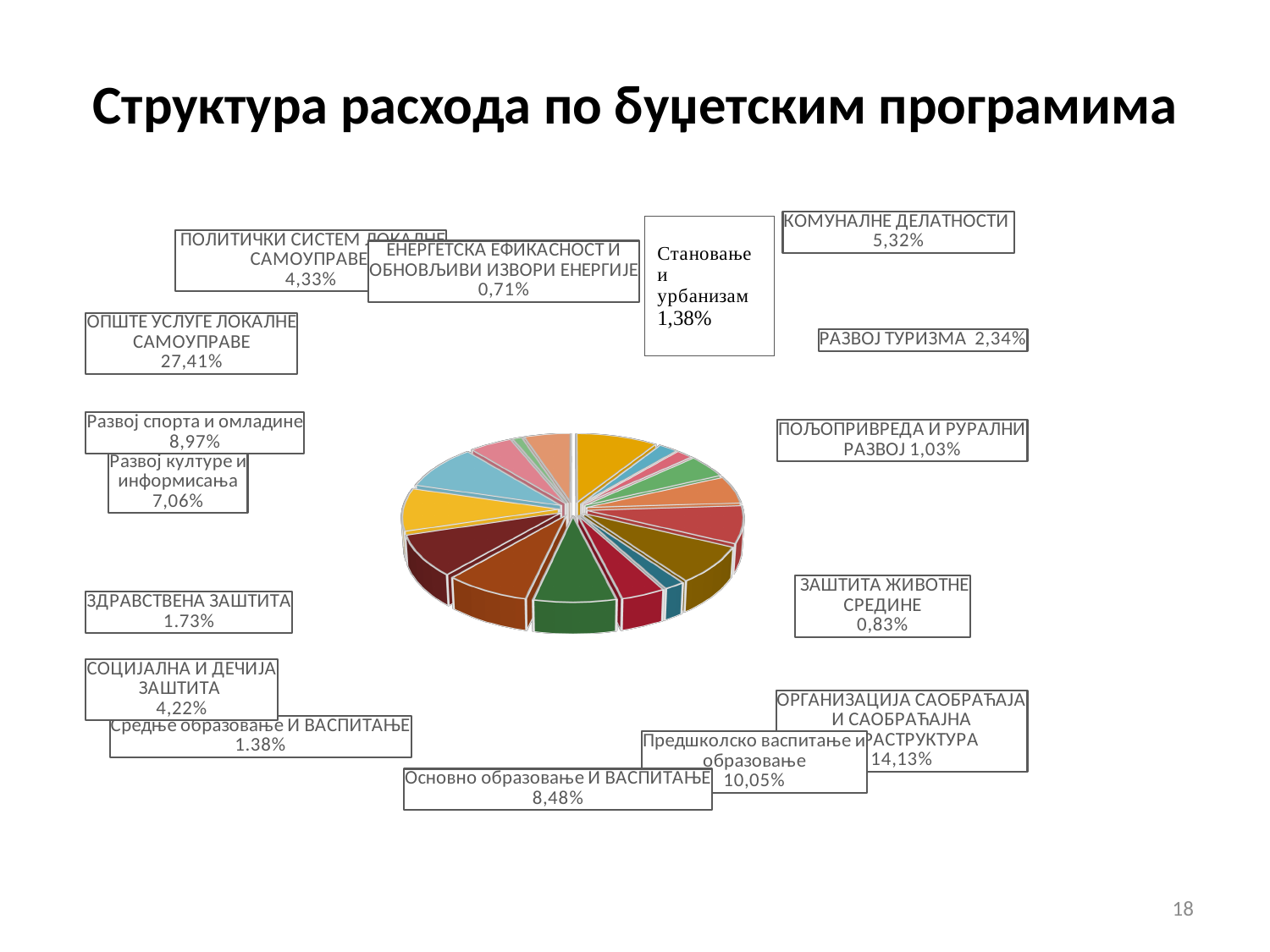
What share is shown for ОРГАНИЗАЦИЈА САОБРАЋАЈА И САОБРАЋАЈНА ИНФРАСТРУКТУРА? 14,13% What is the title of the slide's chart? Структура расхода по буџетским програмима What is the difference in share between Развој спорта и омладине and Основно образовање И ВАСПИТАЊЕ? 0,49% What kind of chart is shown on the slide? Pie chart What share is shown for КОМУНАЛНЕ ДЕЛАТНОСТИ? 5,32% What share is shown for ОПШТЕ УСЛУГЕ ЛОКАЛНЕ САМОУПРАВЕ? 27,41% What is the difference in share between ОРГАНИЗАЦИЈА САОБРАЋАЈА И САОБРАЋАЈНА ИНФРАСТРУКТУРА and Предшколско васпитање и образовање? 4,08% What share is shown for ЗАШТИТА ЖИВОТНЕ СРЕДИНЕ? 0,83% Which program has the largest share of expenditure? ОПШТЕ УСЛУГЕ ЛОКАЛНЕ САМОУПРАВЕ Which has a larger share: Развој спорта и омладине or Развој културе и информисања? Развој спорта и омладине What share is shown for Предшколско васпитање и образовање? 10,05%